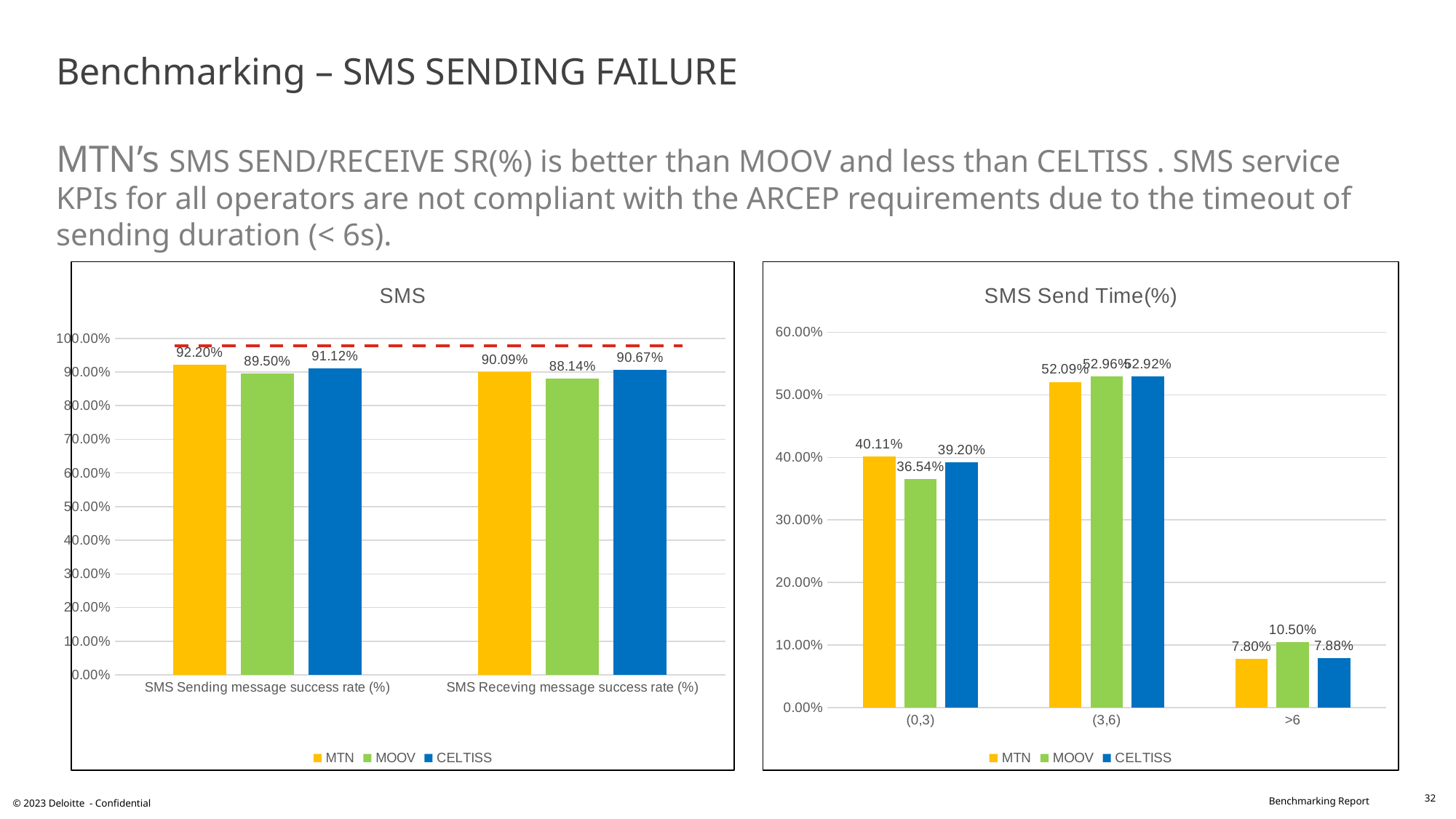
In the SMS chart, which operator has the lowest SMS Sending message success rate (%)? MOOV In the SMS chart, what is the difference between MTN's and MOOV's SMS Sending message success rate (%)? 2.70% What kind of chart is the SMS Send Time(%) chart? Bar chart In the SMS Send Time(%) chart, is MTN's value for (3,6) greater or less than 50.00%? greater In the SMS Send Time(%) chart, what is MOOV's value for (0,3)? 36.54% In the SMS Send Time(%) chart, what is MTN's value for >6? 7.80% In the SMS chart, what is MOOV's SMS Receving message success rate (%)? 88.14% How many categories are shown on the x axis of the SMS Send Time(%) chart? 3 In the SMS chart, what is MTN's SMS Sending message success rate (%)? 92.20% In the SMS chart, which is larger for SMS Receving message success rate (%): CELTISS or MTN? CELTISS In the SMS Send Time(%) chart, which operator has the highest value for >6? MOOV How many series does the legend of the SMS chart list? 3